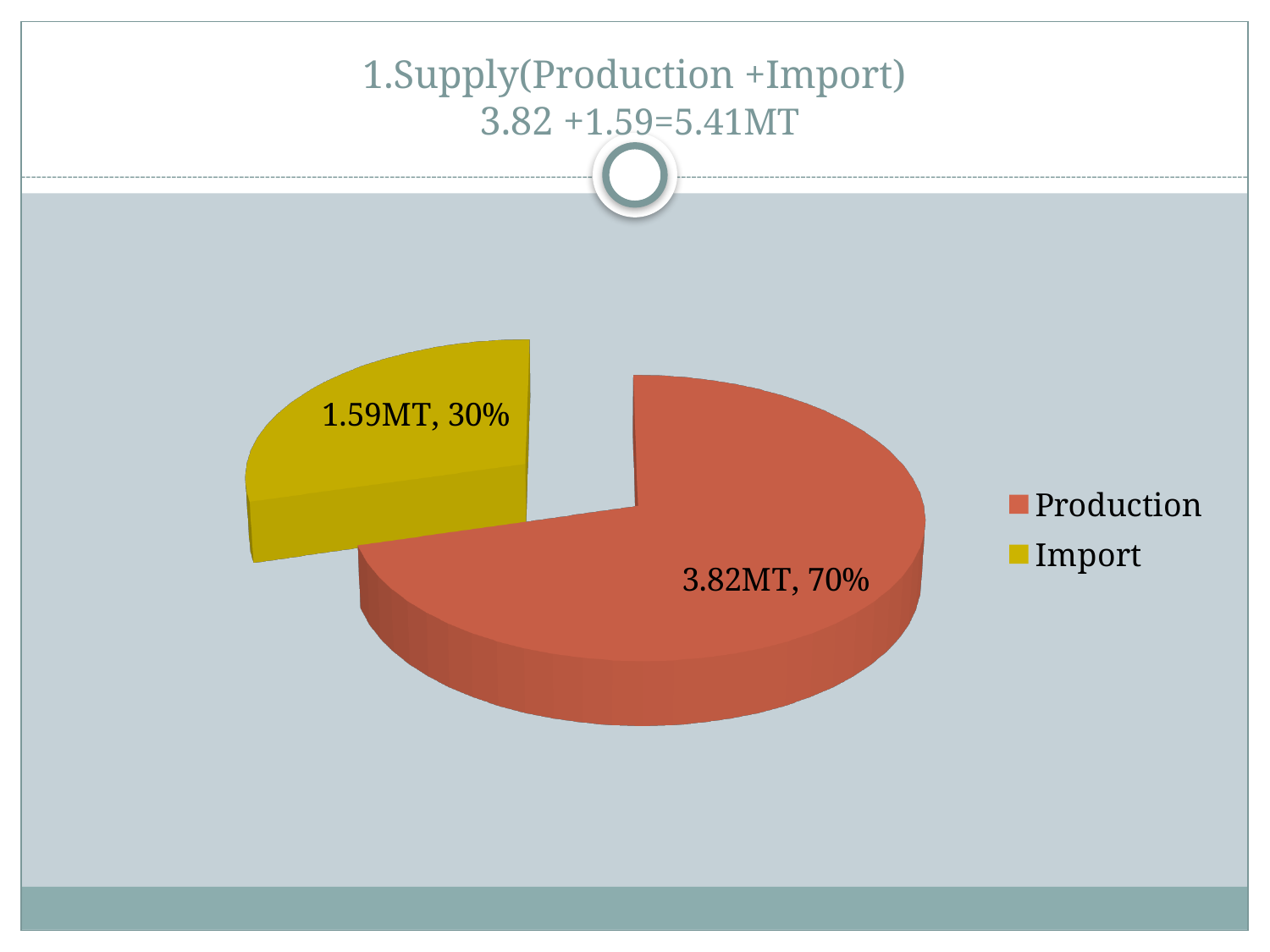
What is the value for Production? 3.82MT What share of the pie does Import represent? 30% What is the difference between the Production and Import values? 2.23MT What colour is the Import slice? yellow What is the total of Production and Import? 5.41MT Which category has the largest slice? Production Which is larger, Production or Import? Production What share of the pie does Production represent? 70% What is the value for Import? 1.59MT How many slices does the pie chart have? 2 What kind of chart is shown on the slide? pie chart Which category has the smallest slice? Import